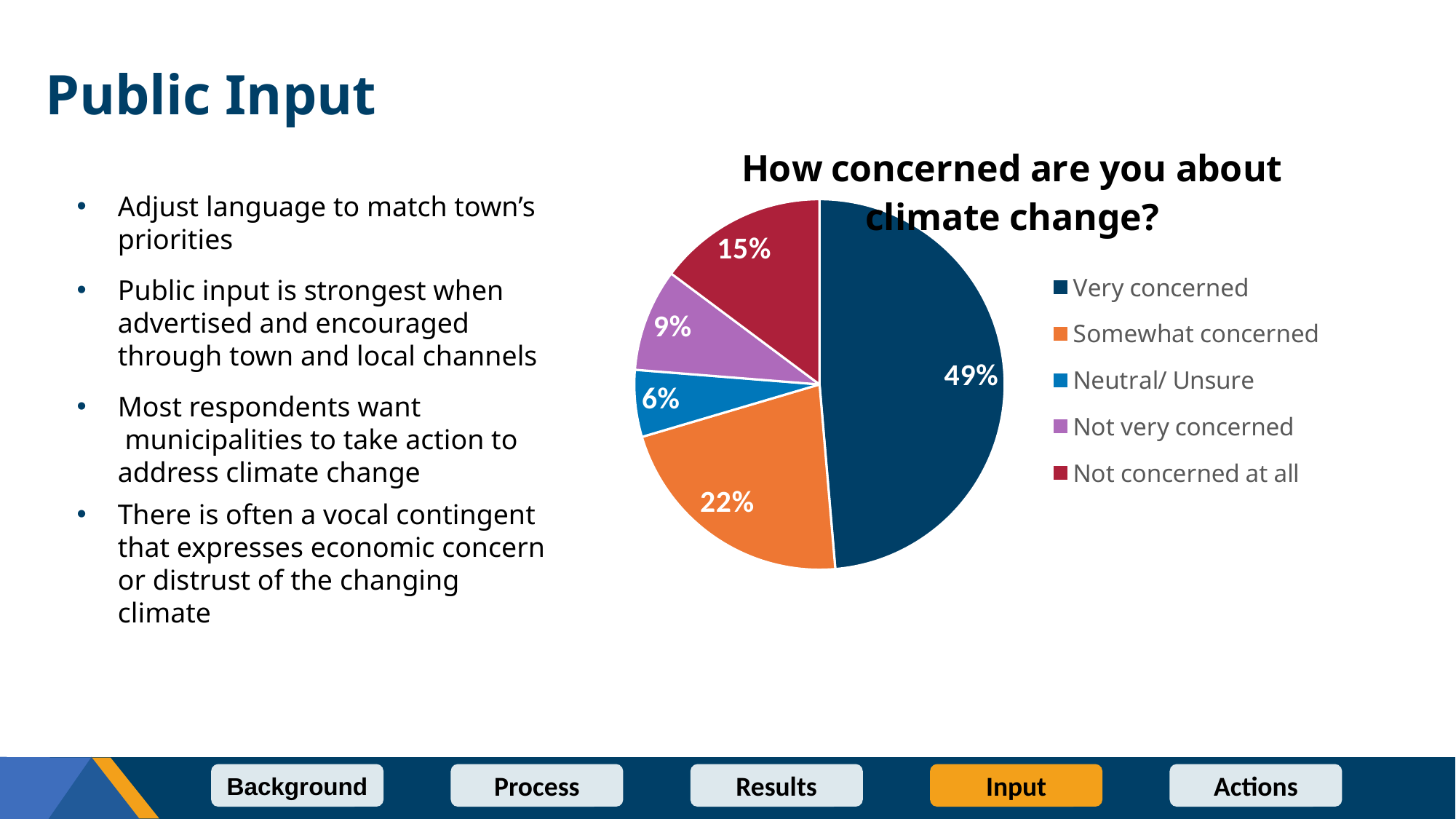
What percentage of respondents are Neutral/ Unsure? 6% What percentage of respondents are Not concerned at all? 15% How many categories does the legend list? 5 What percentage of respondents are Very concerned? 49% What is the title of the chart? How concerned are you about climate change? Which category has the largest share of the pie? Very concerned What percentage of respondents are Not very concerned? 9% What kind of chart is shown on the slide? pie chart Which is larger, the share for Not concerned at all or the share for Not very concerned? Not concerned at all What percentage of respondents are Somewhat concerned? 22% Which category has the smallest share of the pie? Neutral/ Unsure What is the difference in percentage points between Very concerned and Somewhat concerned? 27